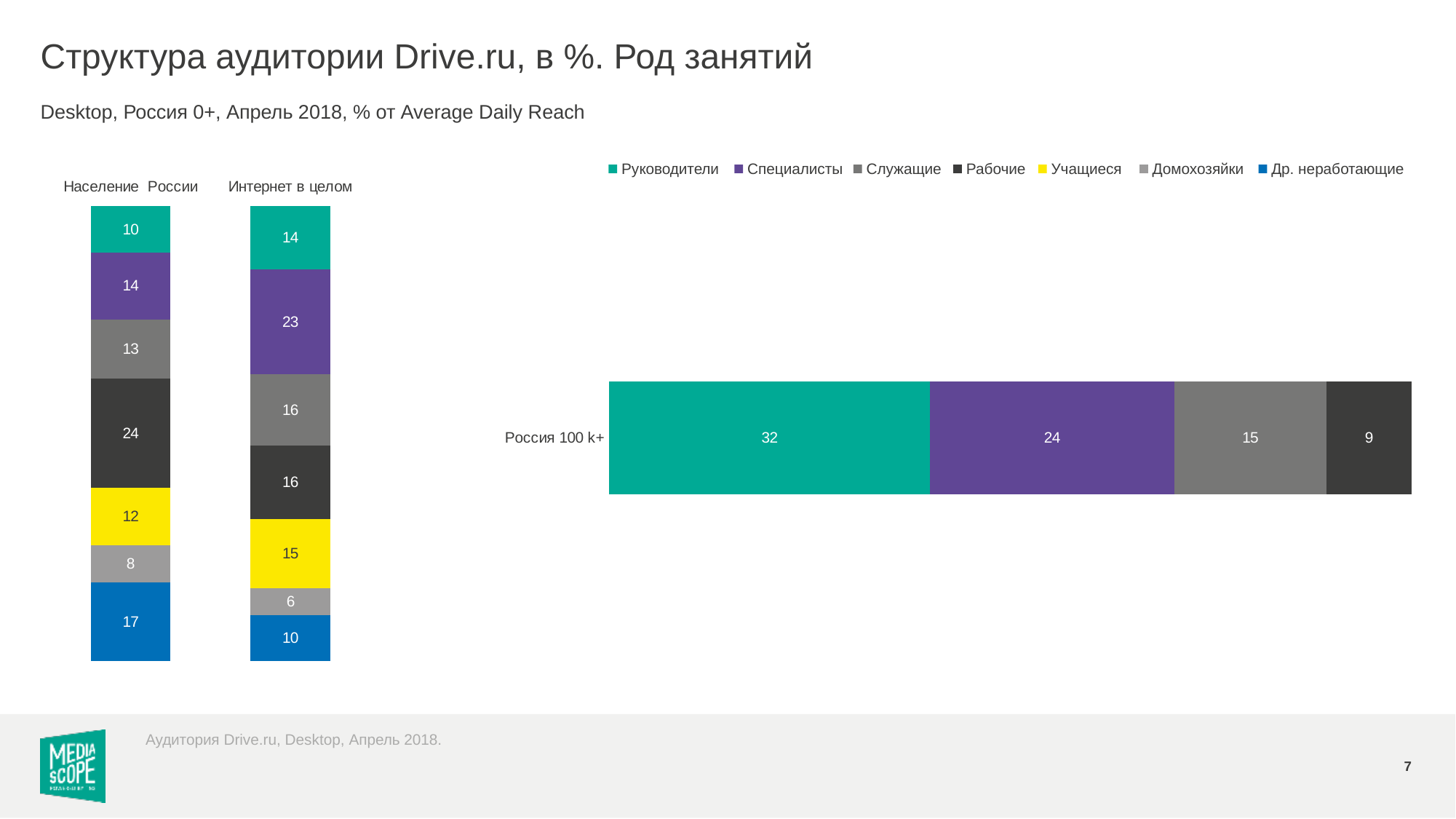
In the 'Интернет в целом' bar, which occupation group has the smallest share? Домохозяйки In the 'Население России' bar, what is the value for Рабочие? 24 What kind of chart is used on this slide? Stacked bar chart What is the total of the 'Интернет в целом' stacked bar? 100 What colour represents Учащиеся in the legend? Yellow In the 'Интернет в целом' bar, what is the value for Специалисты? 23 In the 'Россия 100 k+' bar, what is the value for Руководители? 32 In the 'Россия 100 k+' bar, what is the value for Рабочие? 9 In the 'Население России' bar, which occupation group has the largest share? Рабочие How many series does the legend list? 7 How much larger is the Специалисты value in 'Интернет в целом' than in 'Население России'? 9 Which has the larger Руководители value: 'Россия 100 k+' or 'Интернет в целом'? Россия 100 k+